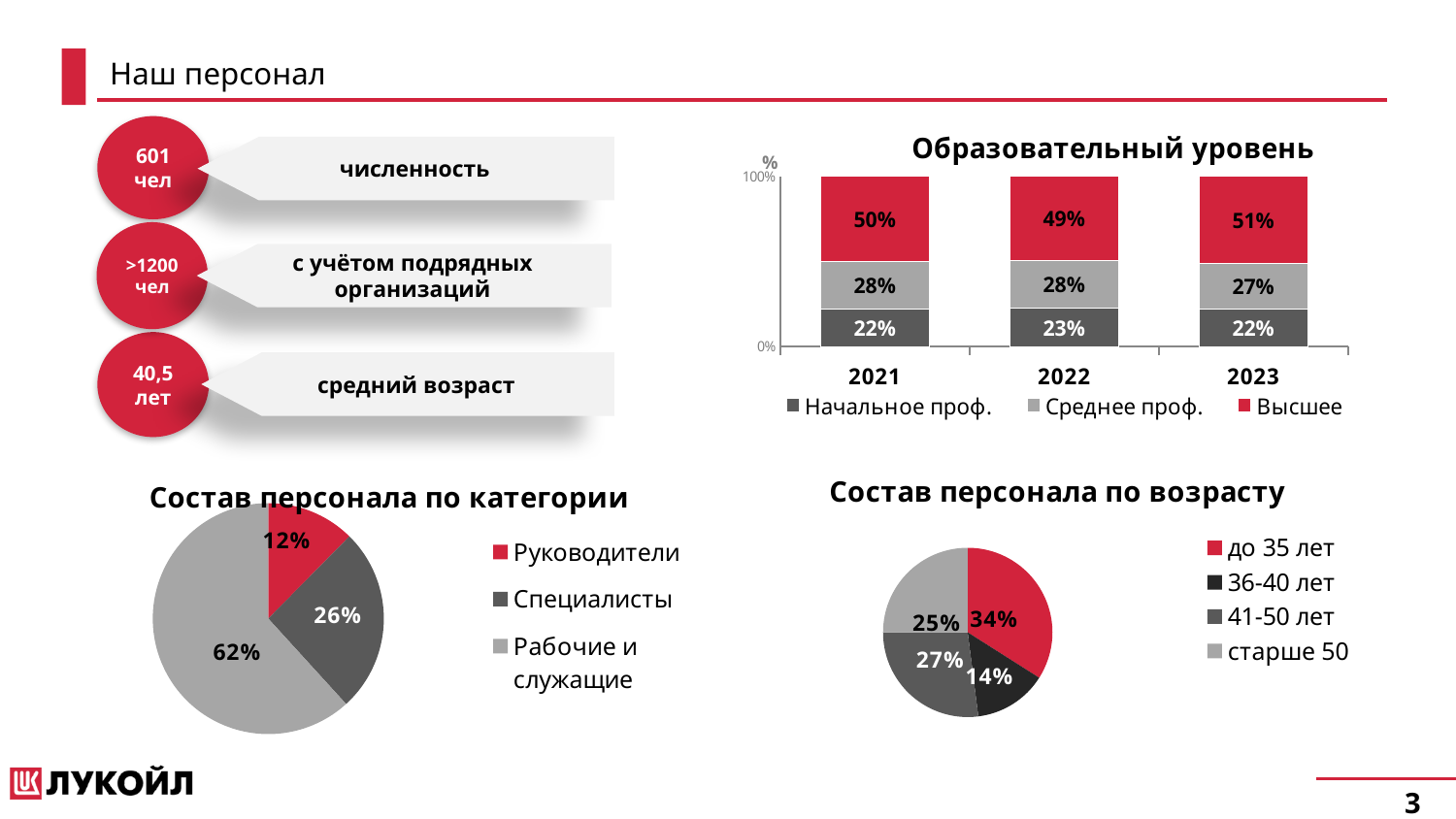
In the 'Состав персонала по возрасту' chart, which age group has the largest slice? до 35 лет In the 'Состав персонала по категории' chart, what is the share for Рабочие и служащие? 62% In the 'Образовательный уровень' chart, which year has the highest share of Высшее? 2023 What kind of chart is 'Образовательный уровень'? Stacked bar chart In the 'Образовательный уровень' chart, how many series does the legend list? 3 In the 'Состав персонала по возрасту' chart, how many age groups are shown? 4 In the 'Состав персонала по категории' chart, what is the difference between Специалисты and Руководители? 14% In the 'Образовательный уровень' chart, what is the value for Начальное проф. in 2022? 23% In the 'Образовательный уровень' chart, what is the difference between Высшее and Среднее проф. in 2021? 22% In the 'Образовательный уровень' chart, what is the value for Высшее in 2023? 51% In the 'Состав персонала по категории' chart, which category has the smallest slice? Руководители In the 'Состав персонала по возрасту' chart, what is the share for 36-40 лет? 14%